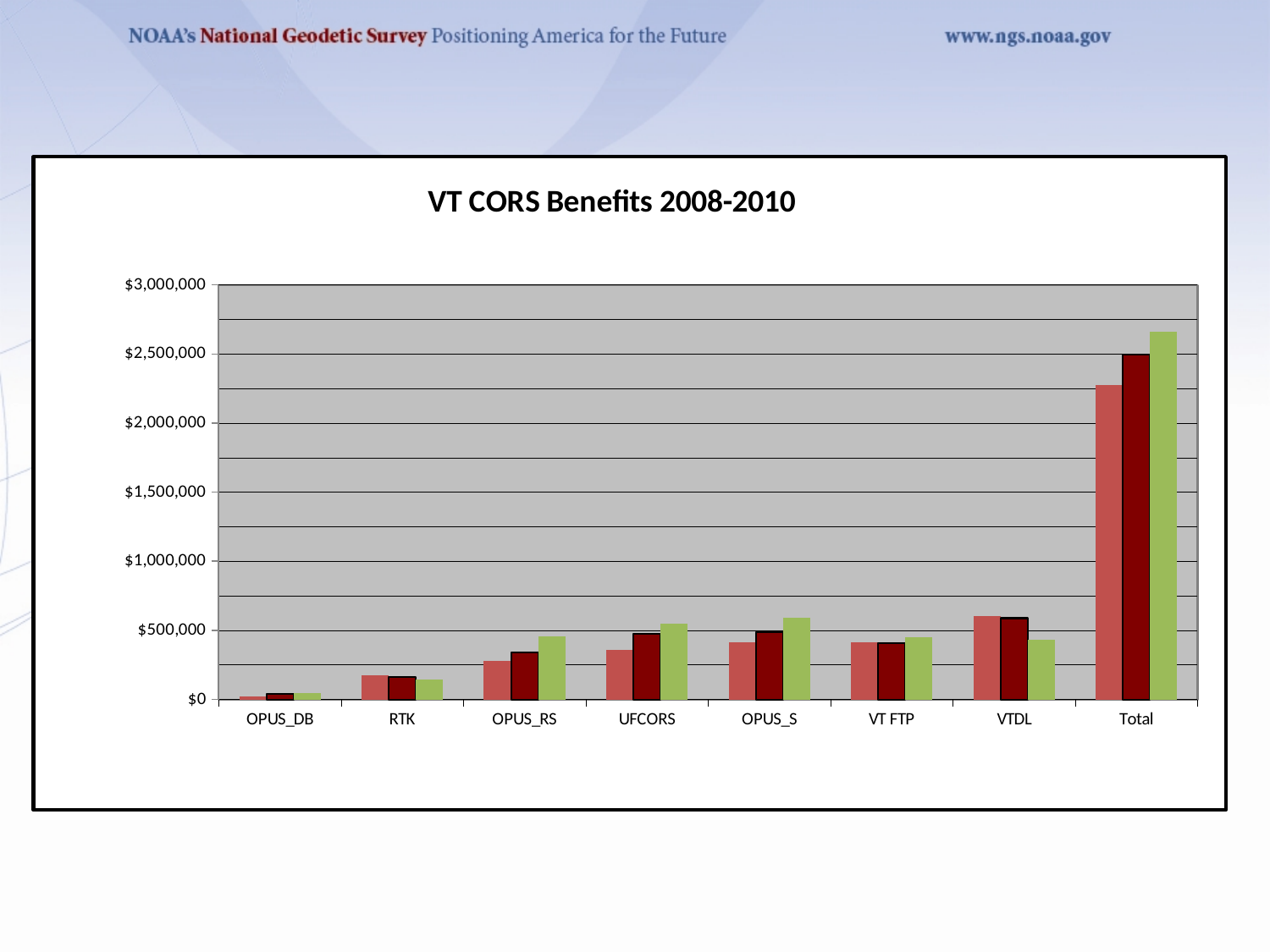
For VTDL, which is larger: the light red (first) bar or the green bar? the light red bar Is the value of the green bar for OPUS_S greater or less than $500,000? greater What kind of chart is shown on the slide? bar chart Is the value of the light red (first) bar for UFCORS greater or less than $500,000? less Is the value of the light red (first) bar for Total greater or less than $2,500,000? less For OPUS_RS, which is larger: the light red (first) bar or the green bar? the green bar What is the title of the chart? VT CORS Benefits 2008-2010 How many categories are shown along the x axis of the chart? 8 Which category has the tallest bars in the chart? Total Which category has the shortest bars in the chart? OPUS_DB